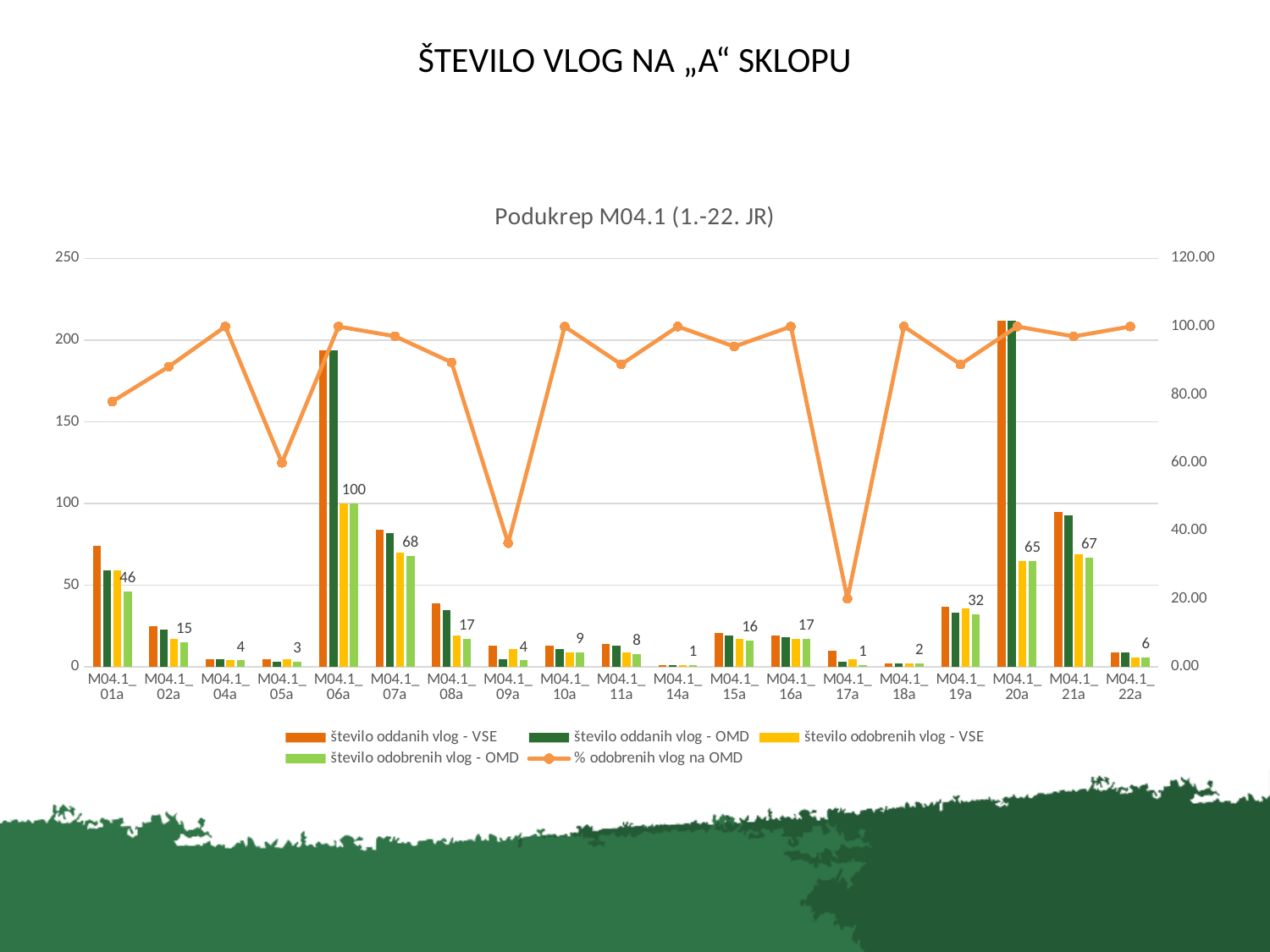
What is the value of 'število odobrenih vlog - OMD' for M04.1_06a? 100 What is the value of 'število odobrenih vlog - OMD' for M04.1_01a? 46 Which has a larger 'število odobrenih vlog - OMD' value, M04.1_02a or M04.1_08a? M04.1_08a What is the value of 'število odobrenih vlog - OMD' for M04.1_19a? 32 Is the value of 'število oddanih vlog - VSE' for M04.1_20a greater or less than 200? greater Is the value of '% odobrenih vlog na OMD' for M04.1_17a greater or less than 40.00? less What is the title of the chart? Podukrep M04.1 (1.-22. JR) What kind of chart is this? Combined bar and line chart What is the difference between the 'število odobrenih vlog - OMD' values for M04.1_06a and M04.1_07a? 32 How many series does the legend list? 5 How many categories are shown on the x axis? 19 Which category has the highest value for 'število odobrenih vlog - OMD'? M04.1_06a